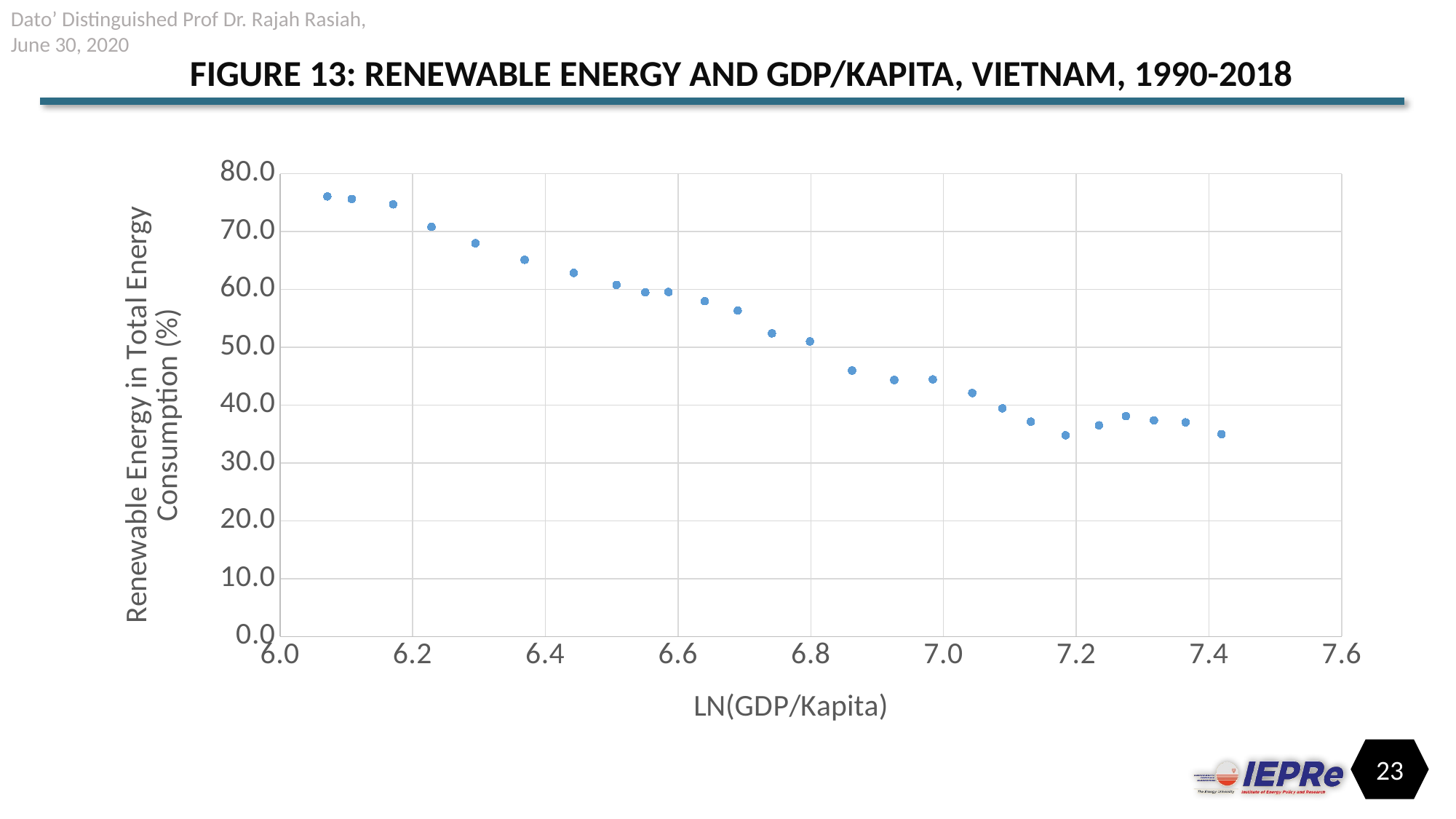
Which point has the highest renewable energy share: the one at LN(GDP/Kapita) near 6.1 or the one near 7.4? the one near 6.1 Is the renewable energy share for the point at LN(GDP/Kapita) of about 7.0 greater or less than 50.0? less Is the renewable energy share for the leftmost point (LN(GDP/Kapita) near 6.1) greater or less than 70.0? greater Is the renewable energy share for the point at LN(GDP/Kapita) of about 6.4 greater or less than 60.0? greater What is the label of the x axis? LN(GDP/Kapita) What is the title of the chart? FIGURE 13: RENEWABLE ENERGY AND GDP/KAPITA, VIETNAM, 1990-2018 Where on the x axis is the point with the highest renewable energy share located: at the lowest or the highest LN(GDP/Kapita) value? the lowest What kind of chart is shown on the slide? scatter plot What is the maximum value shown on the y axis? 80.0 As LN(GDP/Kapita) increases along the x axis, do the renewable energy values generally rise or fall? fall